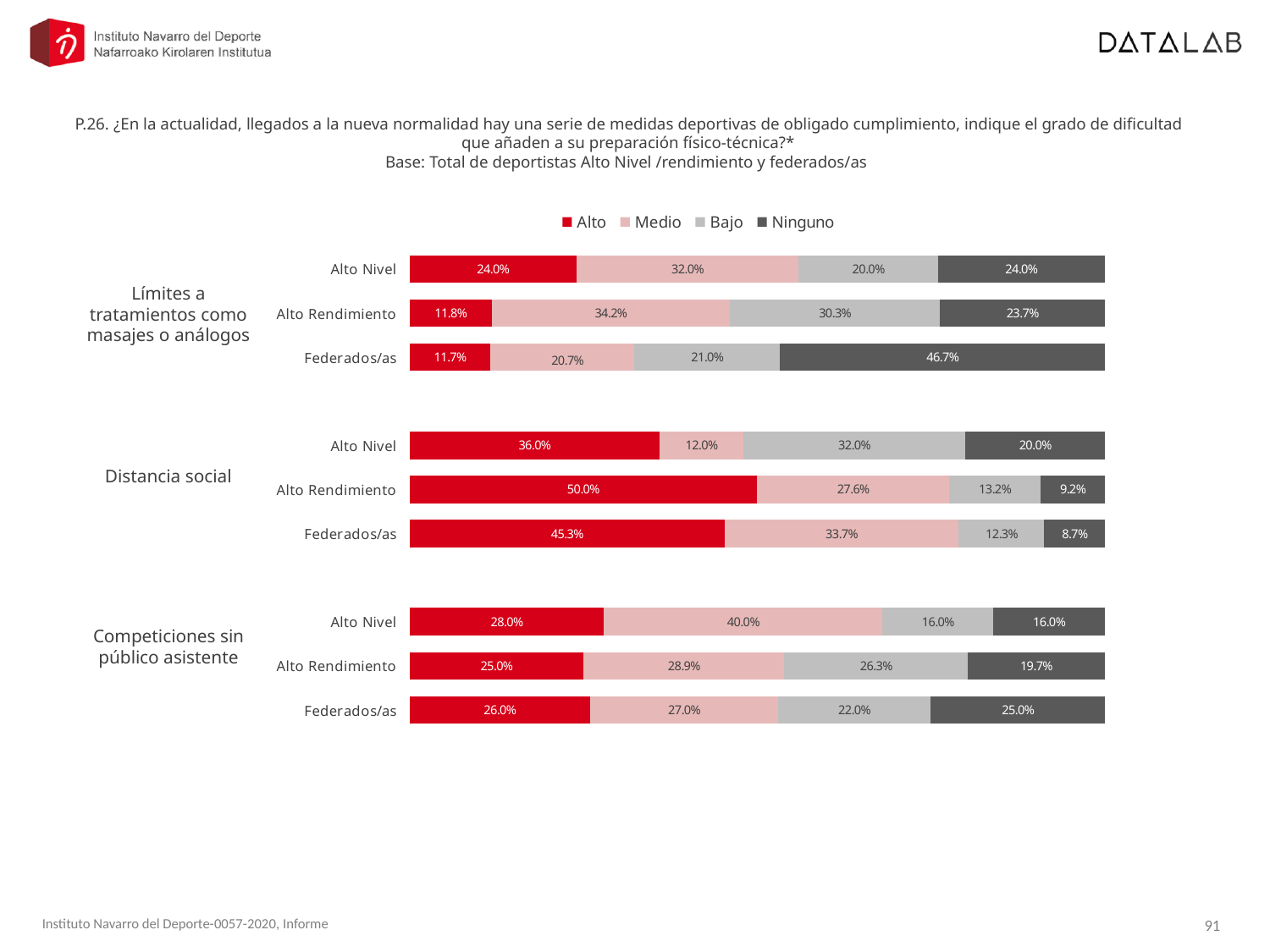
How many categories (bars) are plotted in the chart in total? 9 Which series is shown in red in the legend? Alto Under 'Límites a tratamientos como masajes o análogos', which category has the lowest 'Alto' value? Federados/as Under 'Competiciones sin público asistente', which is larger: the 'Medio' value for Alto Nivel or for Federados/as? Alto Nivel Under 'Distancia social', which category has the highest 'Alto' value? Alto Rendimiento How many series does the legend list? 4 What is the 'Medio' value for Alto Nivel under 'Competiciones sin público asistente'? 40.0% What kind of chart is shown on the slide? Stacked bar chart What is the 'Bajo' value for Alto Rendimiento under 'Límites a tratamientos como masajes o análogos'? 30.3% What is the 'Alto' value for Alto Rendimiento under 'Distancia social'? 50.0% What is the difference between the 'Ninguno' values for Federados/as and Alto Nivel under 'Límites a tratamientos como masajes o análogos'? 22.7% What is the 'Ninguno' value for Federados/as under 'Límites a tratamientos como masajes o análogos'? 46.7%